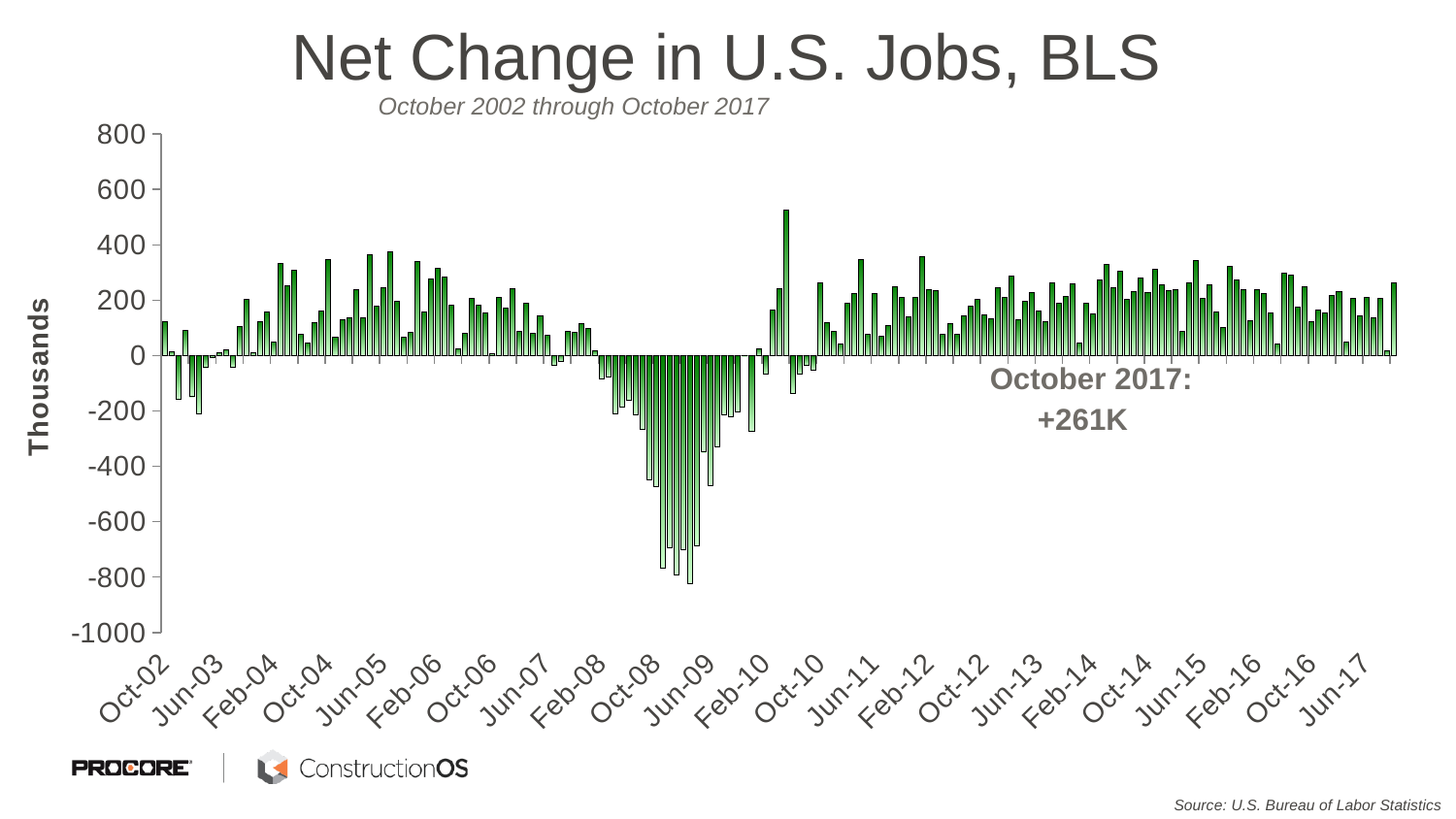
Is the value for Oct-17 greater or less than 200? greater In which year does the lowest bar on the chart occur? 2009 Is the value for Oct-08 greater or less than -200? less What label is shown on the vertical axis of the chart? Thousands What kind of chart is shown on the slide? bar chart Is the value for Jun-09 greater or less than -200? less In which year does the highest bar on the chart occur? 2010 What is the title of the chart? Net Change in U.S. Jobs, BLS Which has the larger value, Oct-17 or Oct-02? Oct-17 What is the net change in U.S. jobs for October 2017 according to the annotation on the chart? +261K